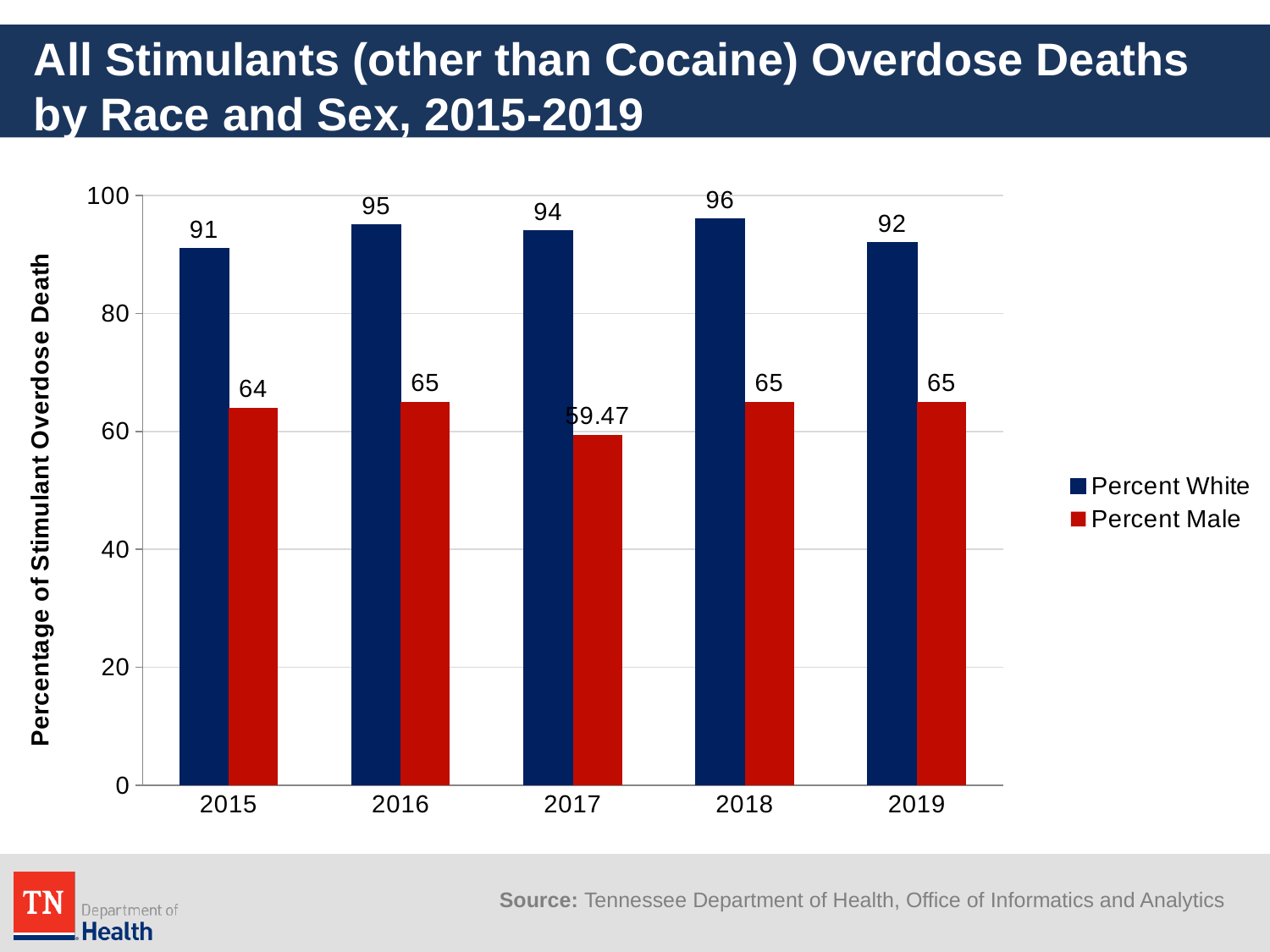
Which year has the highest Percent White value? 2018 What is the label of the y axis? Percentage of Stimulant Overdose Death How many years are shown on the x axis? 5 How many series does the legend list? 2 Which is larger, the Percent White value for 2016 or for 2019? 2016 Which colour represents Percent Male in the legend? Red Which year has the lowest Percent Male value? 2017 What is the Percent Male value for 2017? 59.47 What is the Percent White value for 2015? 91 What kind of chart is shown on the slide? Bar chart What is the Percent White value for 2018? 96 What is the difference between Percent White and Percent Male in 2019? 27